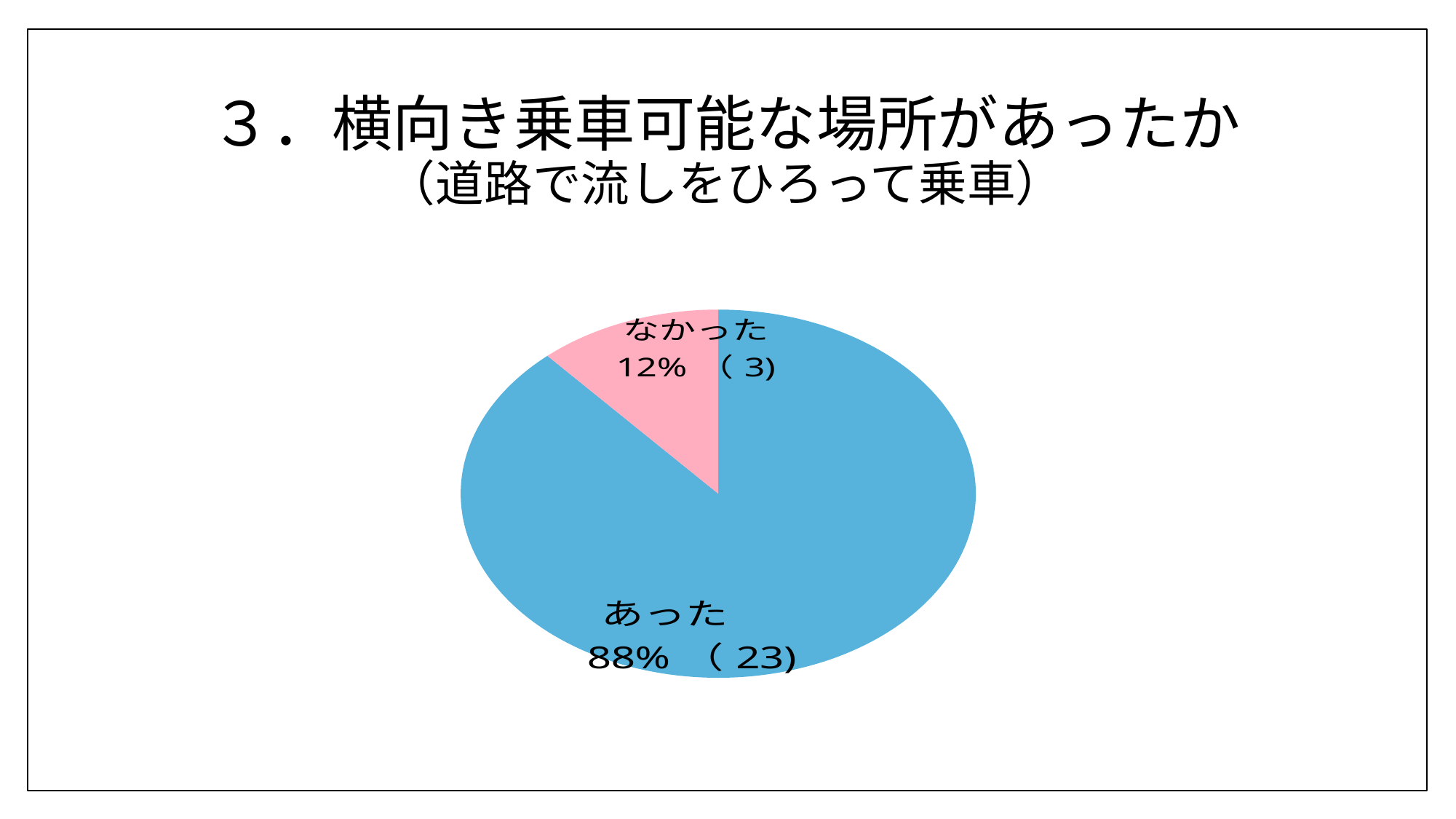
What count is shown in parentheses for あった? 23 What is the total number of responses shown across both slices? 26 Which slice is the smallest in the pie chart? なかった What colour is the なかった slice? pink What percentage share does the なかった slice have? 12% What kind of chart is shown on the slide? pie chart Which slice is the largest in the pie chart? あった What percentage share does the あった slice have? 88% What is the difference in percentage points between the あった and なかった slices? 76 What count is shown in parentheses for なかった? 3 How many slices does the pie chart have? 2 Which slice is larger, あった or なかった? あった